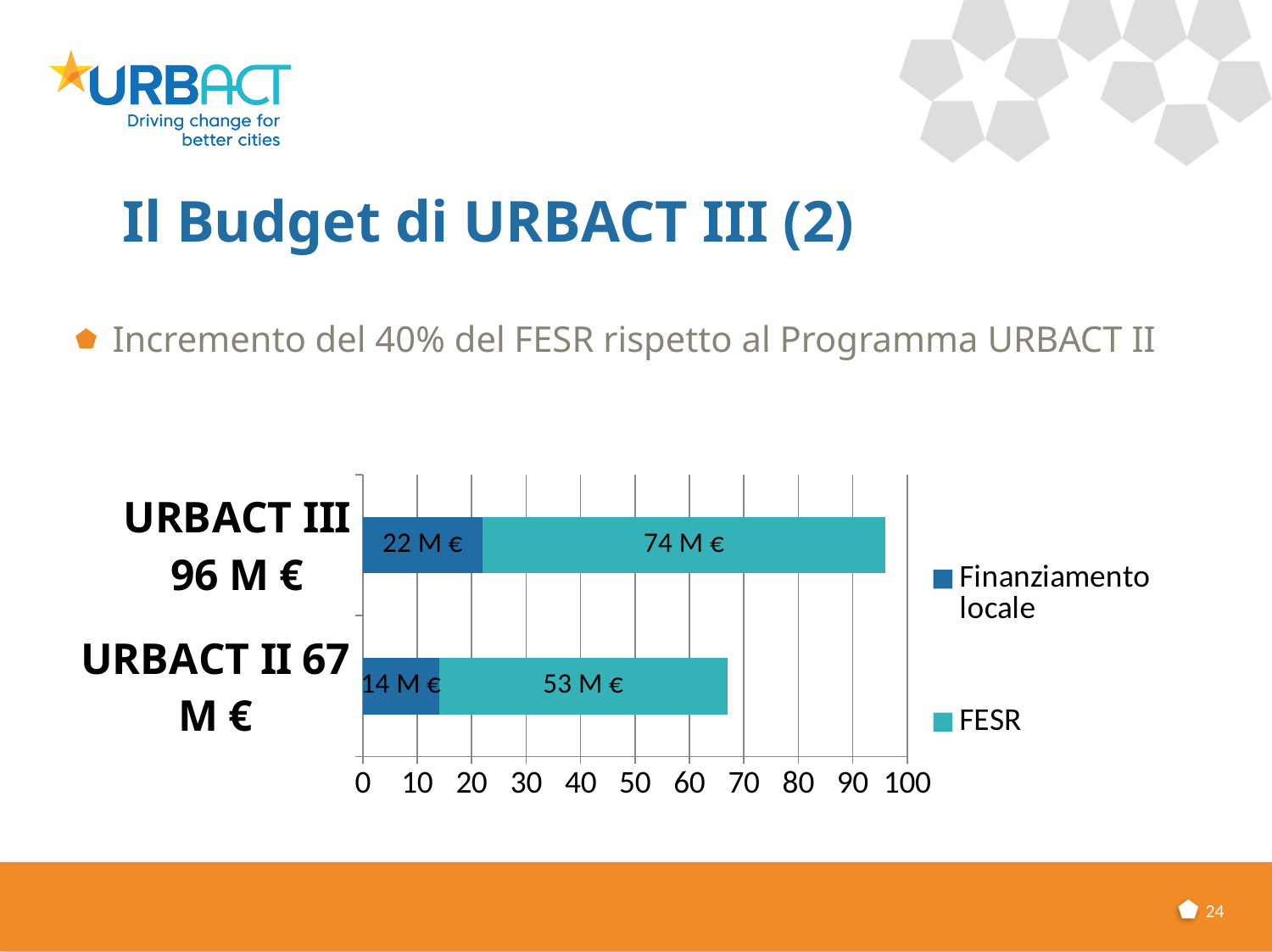
What is the FESR value for URBACT II? 53 M € How many series does the legend list? 2 What is the total of the stacked bar for URBACT II? 67 M € Which programme has the higher FESR value, URBACT II or URBACT III? URBACT III What is the Finanziamento locale value for URBACT II? 14 M € What is the Finanziamento locale value for URBACT III? 22 M € What is the difference between the FESR values of URBACT III and URBACT II? 21 M € What is the total of the stacked bar for URBACT III? 96 M € What is the FESR value for URBACT III? 74 M € What is the difference between the Finanziamento locale values of URBACT III and URBACT II? 8 M € What kind of chart is shown on the slide? Stacked bar chart How many categories are shown on the chart? 2